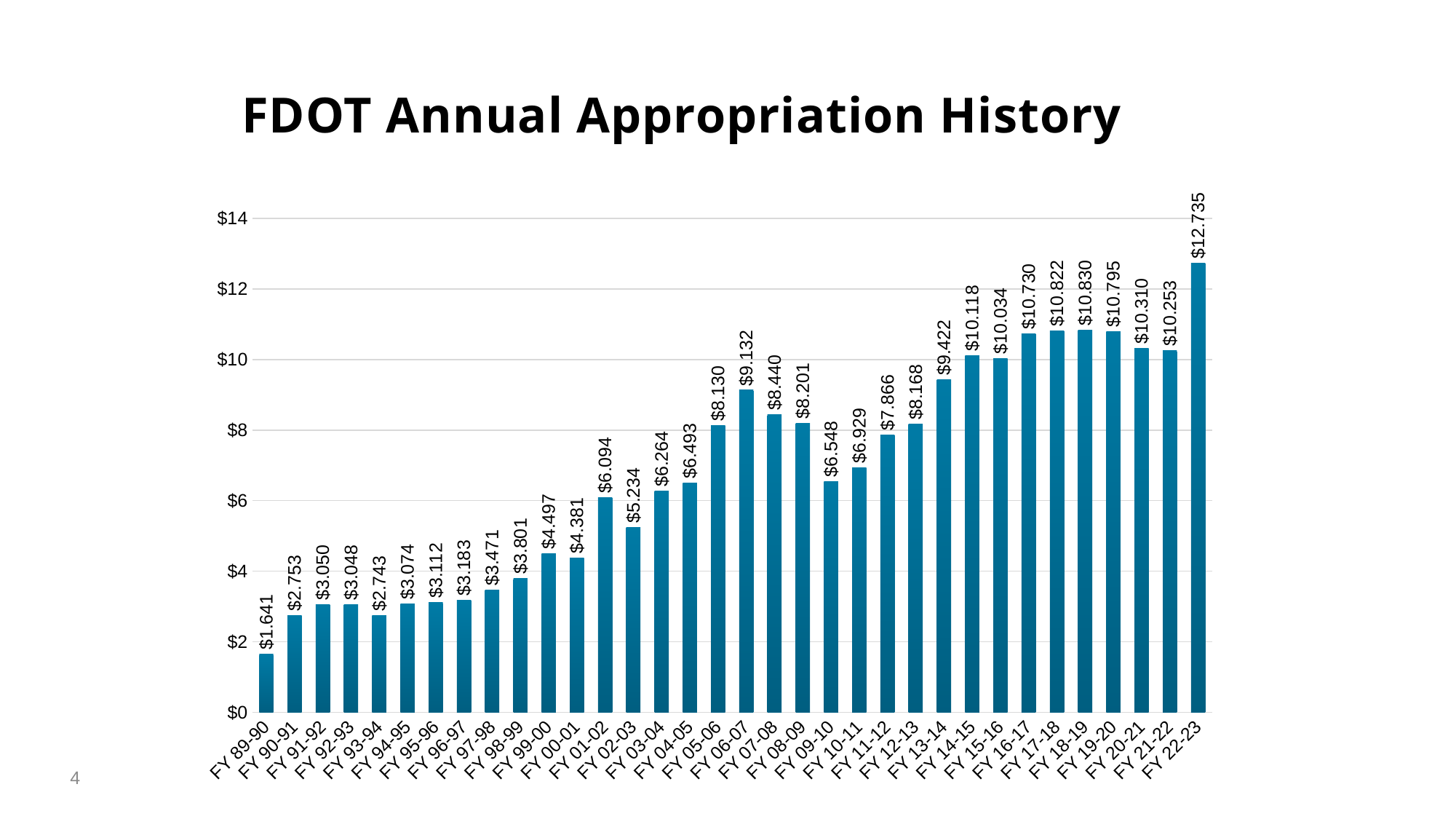
What is the value for FY 06-07? $9.132 Which is larger, the value for FY 09-10 or the value for FY 08-09? FY 08-09 How many fiscal years are shown on the chart? 34 What is the value for FY 22-23? $12.735 What is the value for FY 89-90? $1.641 Is the value for FY 16-17 greater or less than $10? greater What kind of chart is shown on the slide? Bar chart What is the difference between the values for FY 22-23 and FY 21-22? $2.482 Which fiscal year has the lowest value? FY 89-90 What is the difference between the values for FY 06-07 and FY 05-06? $1.002 Which fiscal year has the highest value? FY 22-23 What is the value for FY 13-14? $9.422